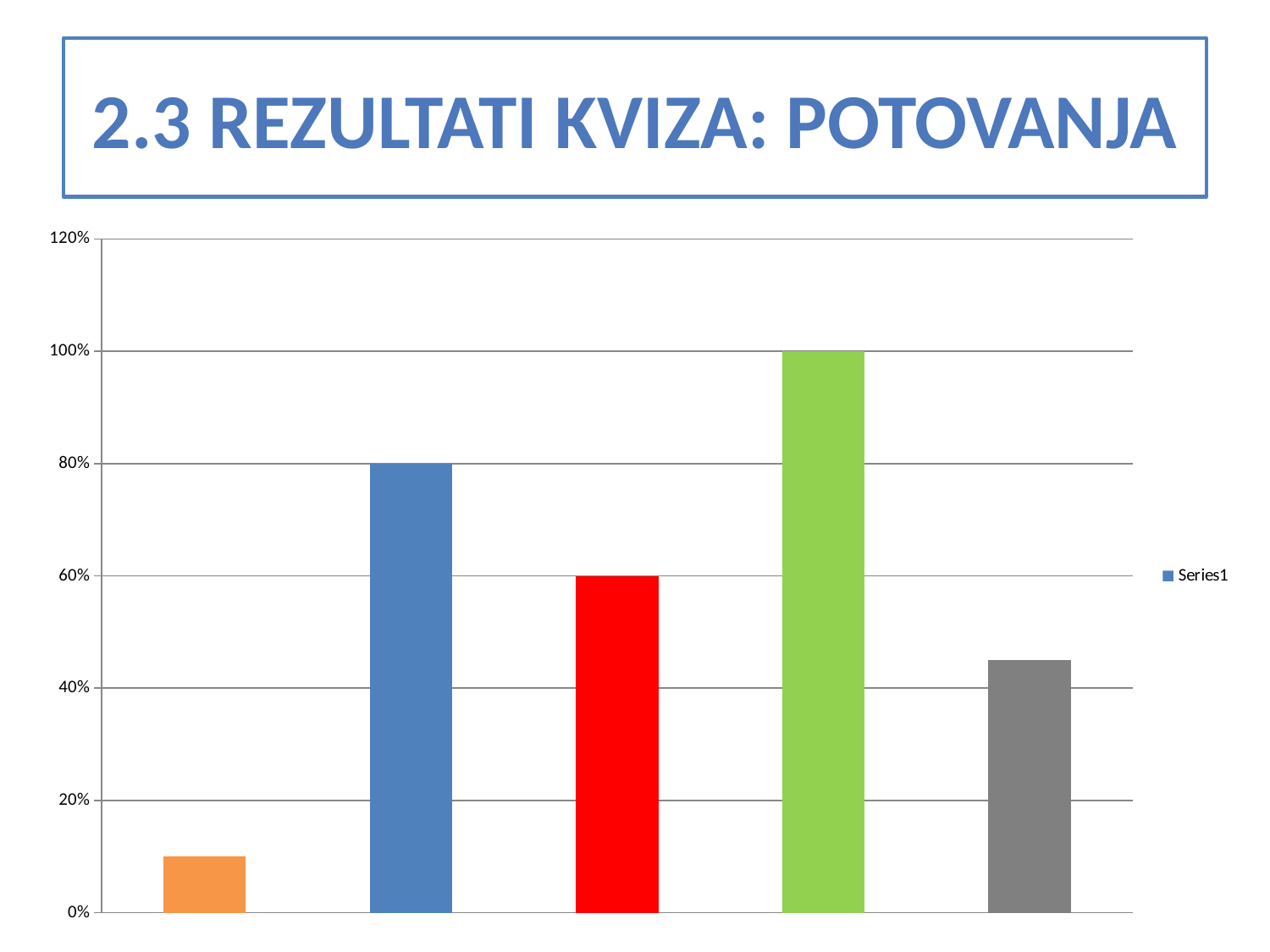
Is the value of the first (orange) bar greater or less than 20%? less What kind of chart is shown on the slide? bar chart How many series does the legend list? 1 What is the name of the series shown in the legend? Series1 What is the value of the fourth (green) bar from the left? 100% What is the value of the second (blue) bar from the left? 80% What is the value of the third (red) bar from the left? 60% Which bar is the lowest in the chart? the first (orange) bar What is the difference between the blue bar and the red bar? 20% Which bar is the highest in the chart? the fourth (green) bar Is the value of the fifth (gray) bar greater or less than 40%? greater How many bars are plotted in the chart? 5